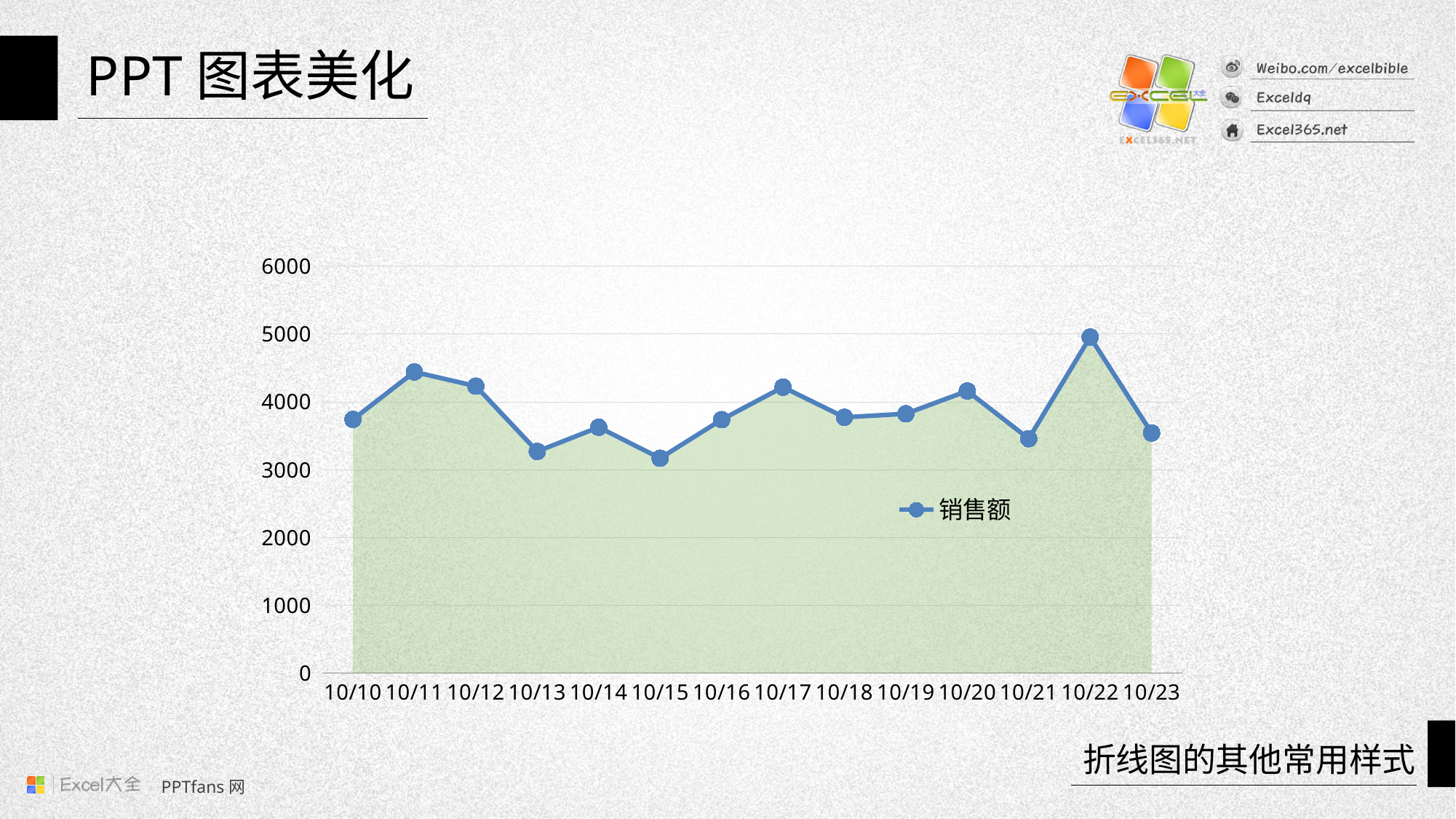
What kind of chart is shown on the slide? line chart Is the value for 10/11 greater or less than 4000? greater Which is larger, the value for 10/11 or the value for 10/13? 10/11 What is the name of the series shown in the legend? 销售额 How many data points are plotted along the x axis? 14 How many series does the legend list? 1 Is the value for 10/15 greater or less than 4000? less On which date is the value lowest? 10/15 Which is larger, the value for 10/22 or the value for 10/23? 10/22 Does the value rise or fall from 10/22 to 10/23? fall Is the value for 10/22 greater or less than 4000? greater On which date is the value highest? 10/22